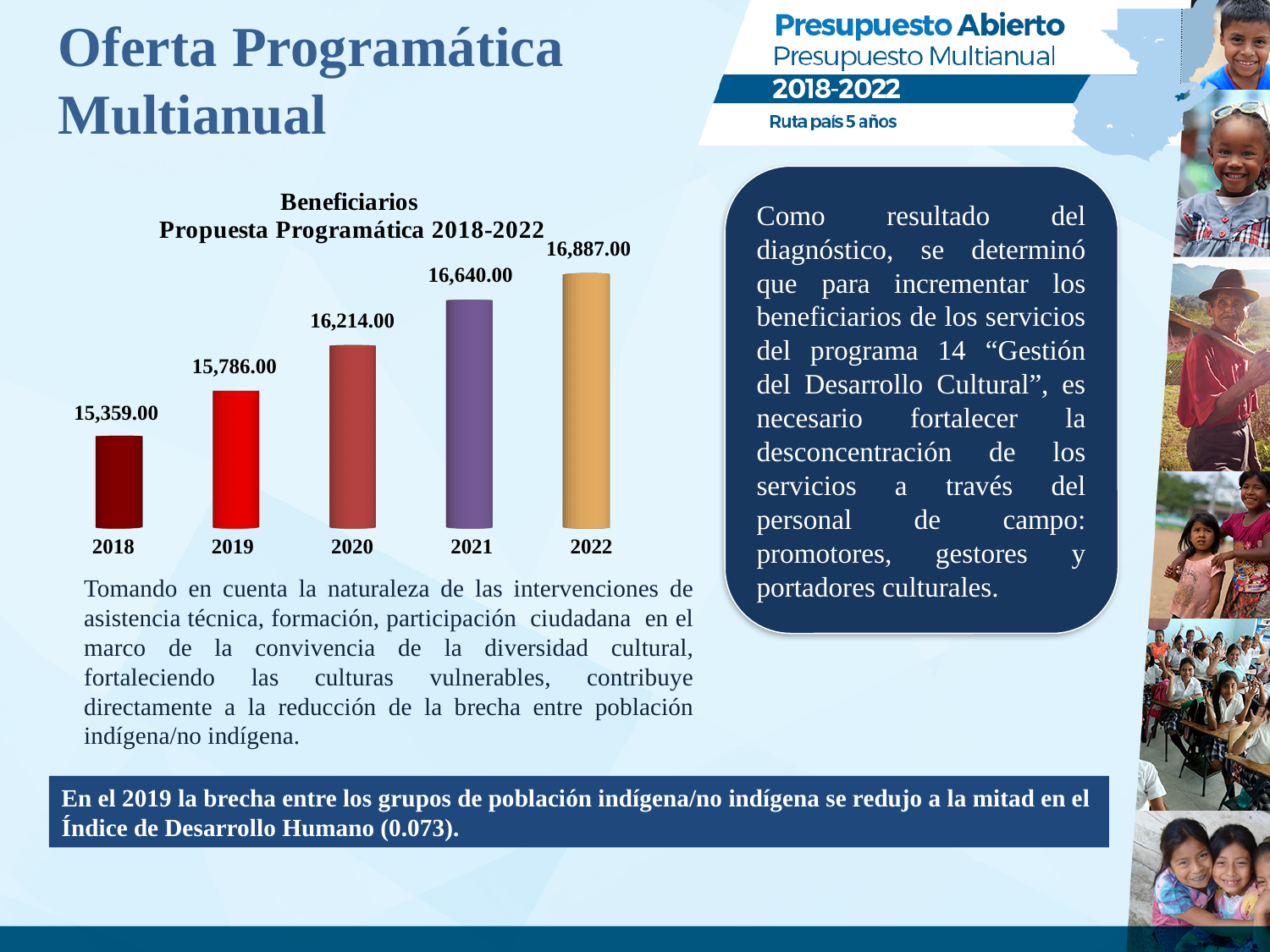
Which is larger in the Beneficiarios chart, the value for 2019 or the value for 2021? 2021 What is the difference between the values for 2022 and 2018 in the Beneficiarios chart? 1,528.00 What kind of chart is the Beneficiarios chart? Bar chart What is the difference between the values for 2021 and 2020 in the Beneficiarios chart? 426.00 Which year has the highest value in the Beneficiarios chart? 2022 What is the value for 2018 in the Beneficiarios chart? 15,359.00 How many years are shown in the Beneficiarios chart? 5 What is the title of the chart on the slide? Beneficiarios Propuesta Programática 2018-2022 What is the value for 2022 in the Beneficiarios chart? 16,887.00 Which year has the lowest value in the Beneficiarios chart? 2018 What is the value for 2020 in the Beneficiarios chart? 16,214.00 Do the values in the Beneficiarios chart rise or fall from 2018 to 2022? Rise